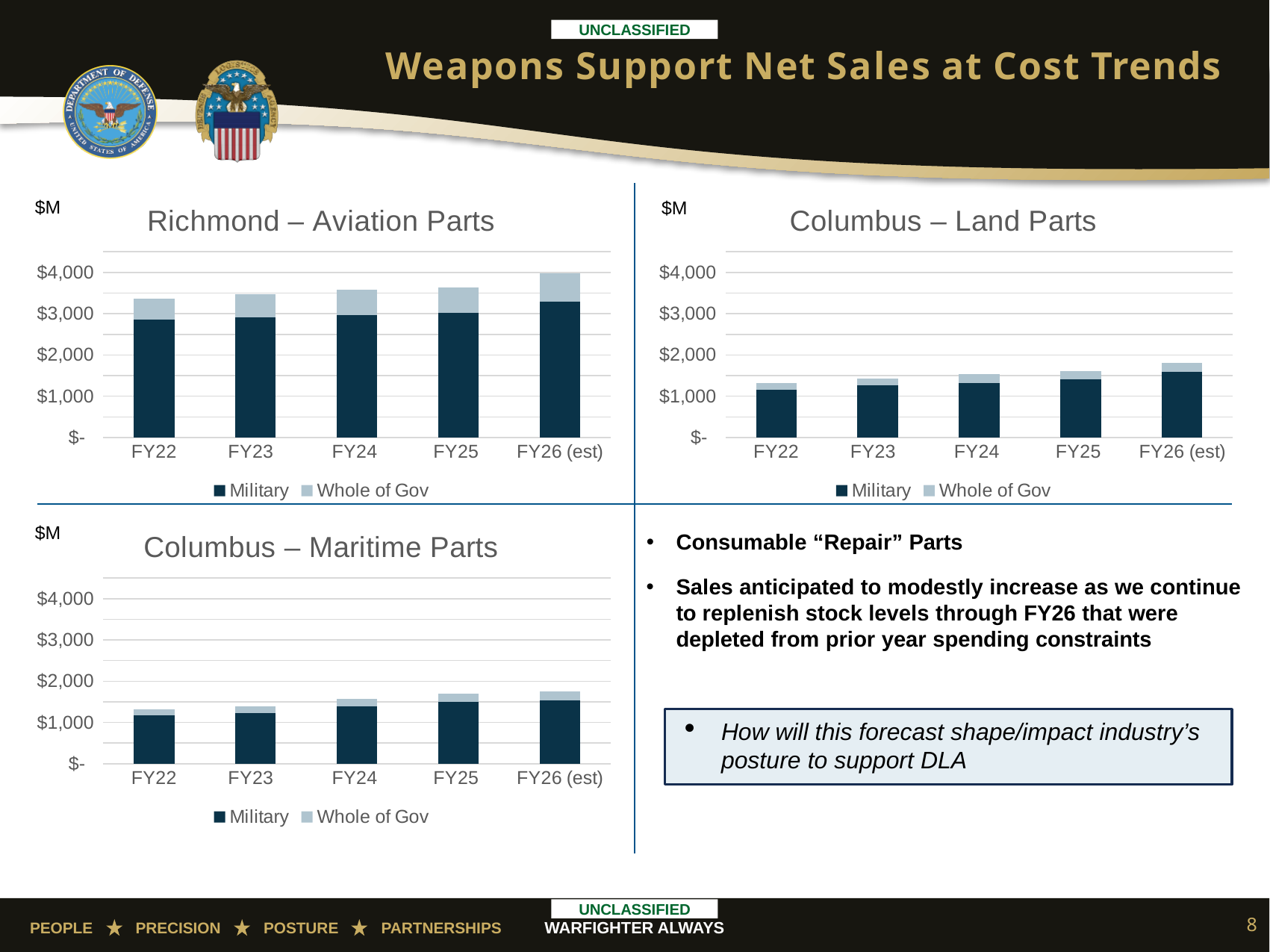
In the Columbus – Maritime Parts chart, do the total bar values rise or fall from FY22 to FY26 (est)? rise What kind of chart is the Richmond – Aviation Parts chart? Stacked bar chart In the Columbus – Maritime Parts chart, is the Military value for FY22 greater or less than $1,000? greater In the Richmond – Aviation Parts chart, which fiscal year has the highest total bar? FY26 (est) What are the two legend entries in the Richmond – Aviation Parts chart? Military and Whole of Gov In the Richmond – Aviation Parts chart, which fiscal year has the lowest total bar? FY22 In the Columbus – Land Parts chart, is the total value for FY26 (est) greater or less than $2,000? less How many fiscal year categories are shown on the x axis of the Columbus – Land Parts chart? 5 Which is larger: the FY26 (est) total in the Richmond – Aviation Parts chart or the FY26 (est) total in the Columbus – Land Parts chart? Richmond – Aviation Parts How many series does the legend of the Columbus – Maritime Parts chart list? 2 In the Columbus – Land Parts chart, which fiscal year has the highest total bar? FY26 (est) In the Richmond – Aviation Parts chart, is the total value for FY26 (est) greater or less than $3,000? greater